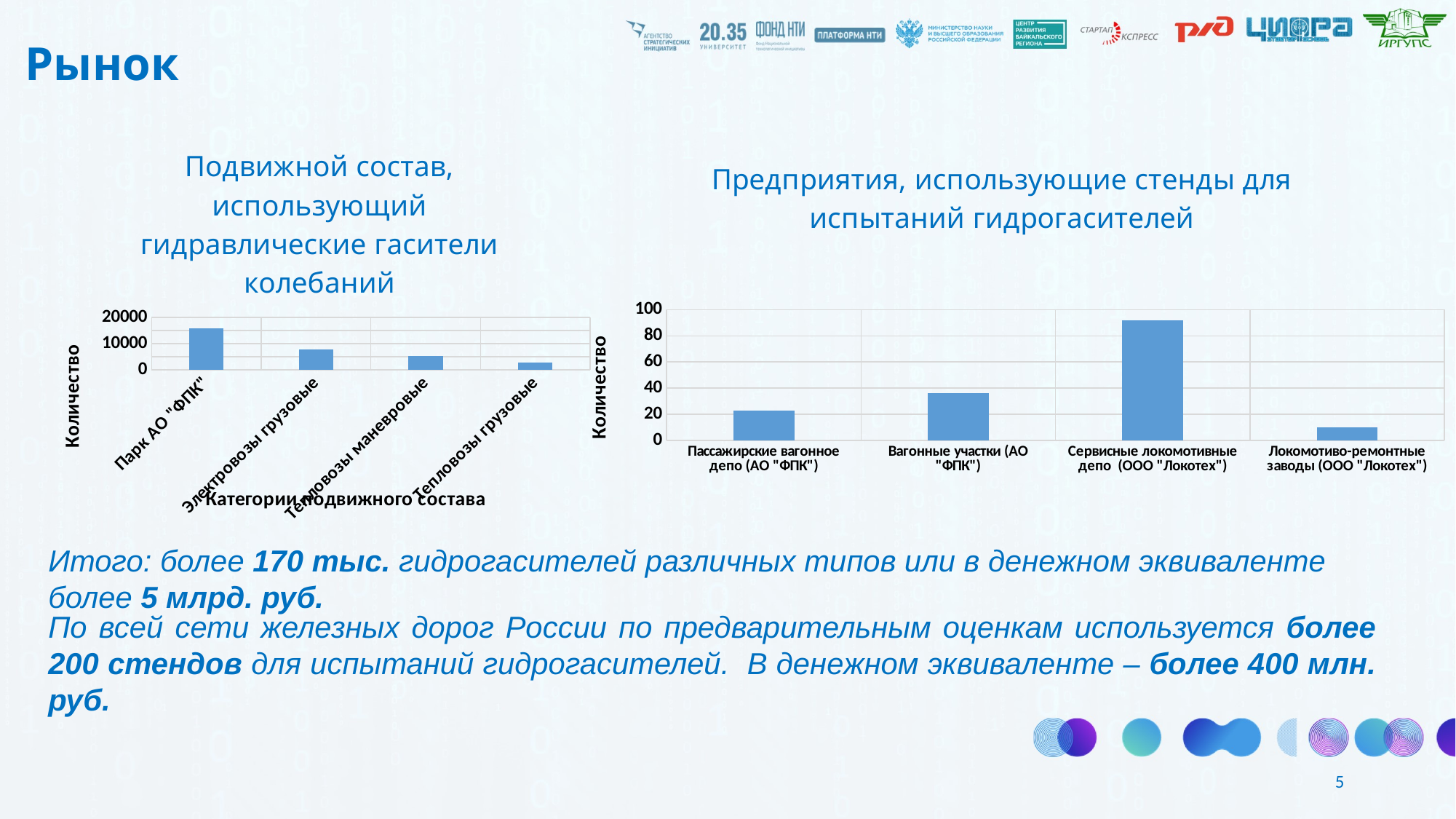
In the chart titled "Предприятия, использующие стенды для испытаний гидрогасителей", how many categories are plotted? 4 In the chart titled "Подвижной состав, использующий гидравлические гасители колебаний", how many categories are plotted? 4 In the chart titled "Подвижной состав, использующий гидравлические гасители колебаний", which category has the lowest value? Тепловозы грузовые In the chart titled "Предприятия, использующие стенды для испытаний гидрогасителей", which is larger: Вагонные участки (АО "ФПК") or Пассажирские вагонное депо (АО "ФПК")? Вагонные участки (АО "ФПК") In the chart titled "Подвижной состав, использующий гидравлические гасители колебаний", what is the x-axis title? Категории подвижного состава In the chart titled "Предприятия, использующие стенды для испытаний гидрогасителей", which category has the lowest value? Локомотиво-ремонтные заводы (ООО "Локотех") In the chart titled "Подвижной состав, использующий гидравлические гасители колебаний", which category has the highest value? Парк АО "ФПК" In the chart titled "Подвижной состав, использующий гидравлические гасители колебаний", do the values rise or fall from left to right? fall In the chart titled "Подвижной состав, использующий гидравлические гасители колебаний", what kind of chart is shown? bar chart In the chart titled "Подвижной состав, использующий гидравлические гасители колебаний", is the value for Парк АО "ФПК" greater or less than 10000? greater In the chart titled "Предприятия, использующие стенды для испытаний гидрогасителей", which category has the highest value? Сервисные локомотивные депо (ООО "Локотех") In the chart titled "Предприятия, использующие стенды для испытаний гидрогасителей", is the value for Сервисные локомотивные депо (ООО "Локотех") greater or less than 80? greater